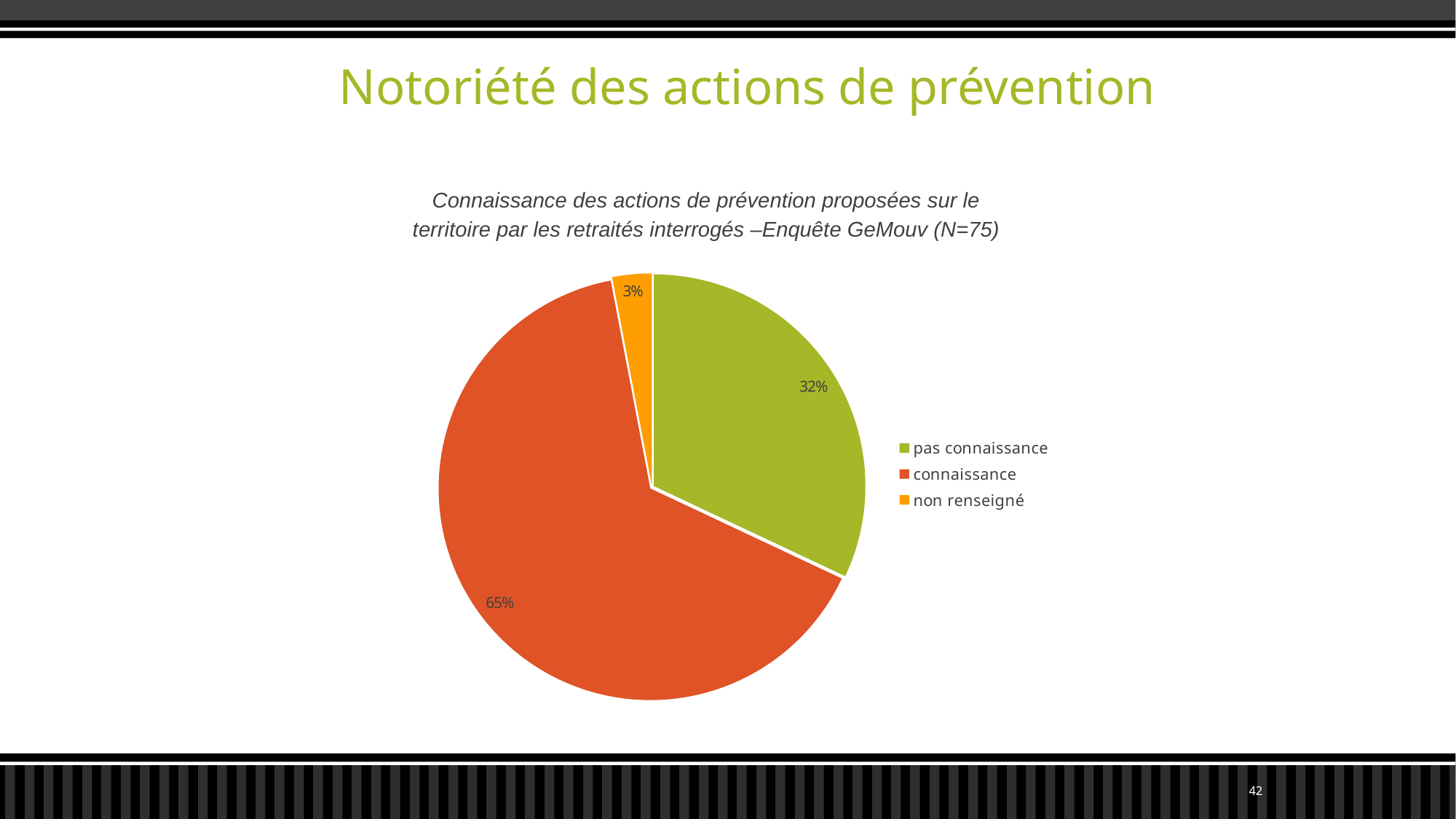
Which category has the largest share of the pie? connaissance What colour is the slice for "connaissance"? orange-red What percentage of respondents is shown for "connaissance"? 65% Which is larger: the share for "pas connaissance" or the share for "non renseigné"? pas connaissance What kind of chart is shown on the slide? pie chart What percentage is shown for "non renseigné"? 3% Which category has the smallest share of the pie? non renseigné How many entries does the legend list? 3 What is the difference in percentage points between "connaissance" and "pas connaissance"? 33 What percentage of respondents is shown for "pas connaissance"? 32% How many categories does the pie chart have? 3 What sample size (N) is stated in the chart title? N=75